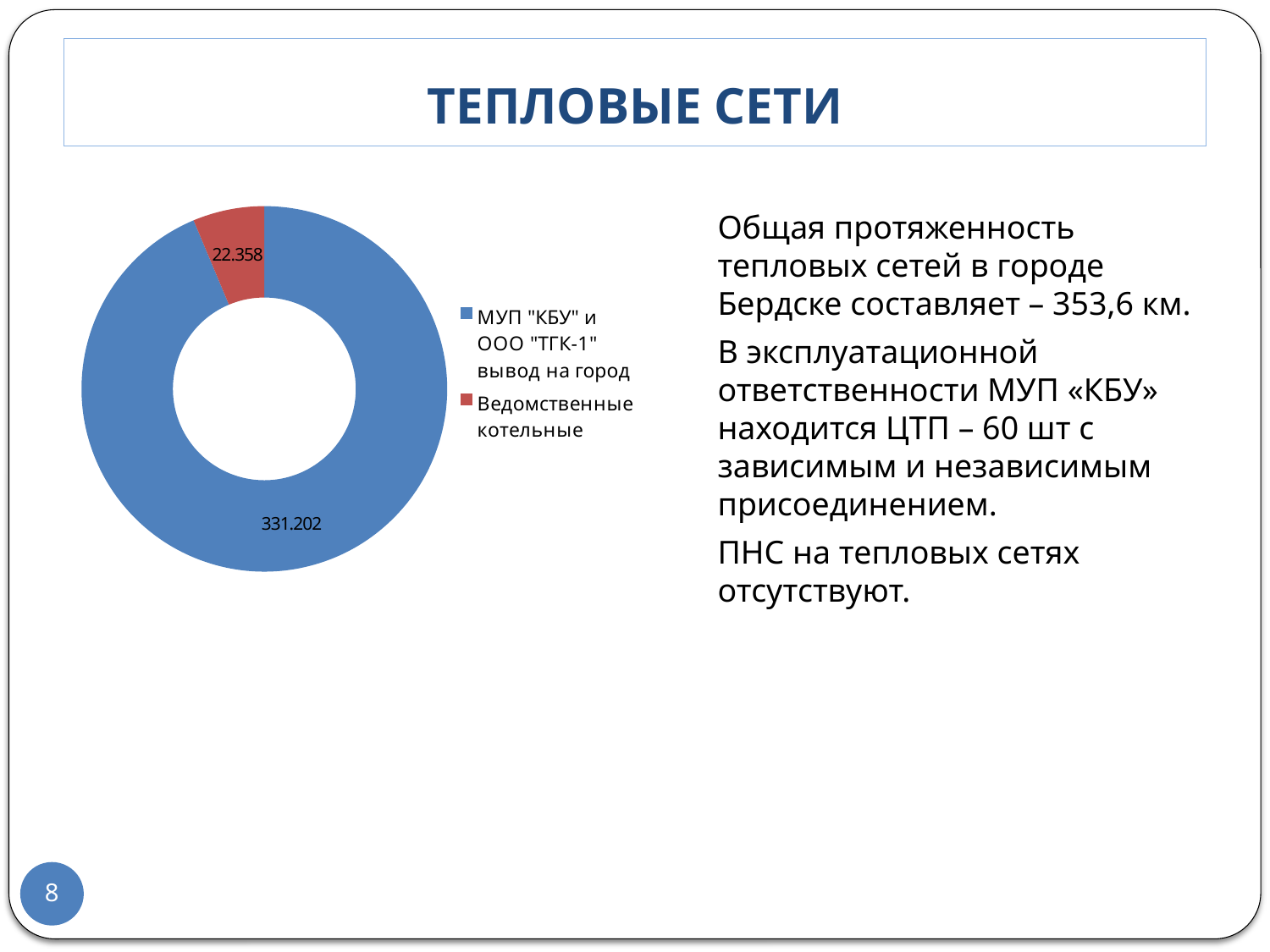
What is the difference between the value for МУП "КБУ" и ООО "ТГК-1" вывод на город and the value for Ведомственные котельные? 308.844 What colour is the slice for МУП "КБУ" и ООО "ТГК-1" вывод на город? Blue Which is larger: the value for Ведомственные котельные or the value for МУП "КБУ" и ООО "ТГК-1" вывод на город? МУП "КБУ" и ООО "ТГК-1" вывод на город What is the total of the two values shown on the chart? 353.56 How many categories does the chart show? 2 What is the value for МУП "КБУ" и ООО "ТГК-1" вывод на город? 331.202 What is the value for Ведомственные котельные? 22.358 What kind of chart is shown on the slide? Doughnut (pie) chart Which category has the largest slice? МУП "КБУ" и ООО "ТГК-1" вывод на город What colour is the slice for Ведомственные котельные? Red Which category has the smallest slice? Ведомственные котельные